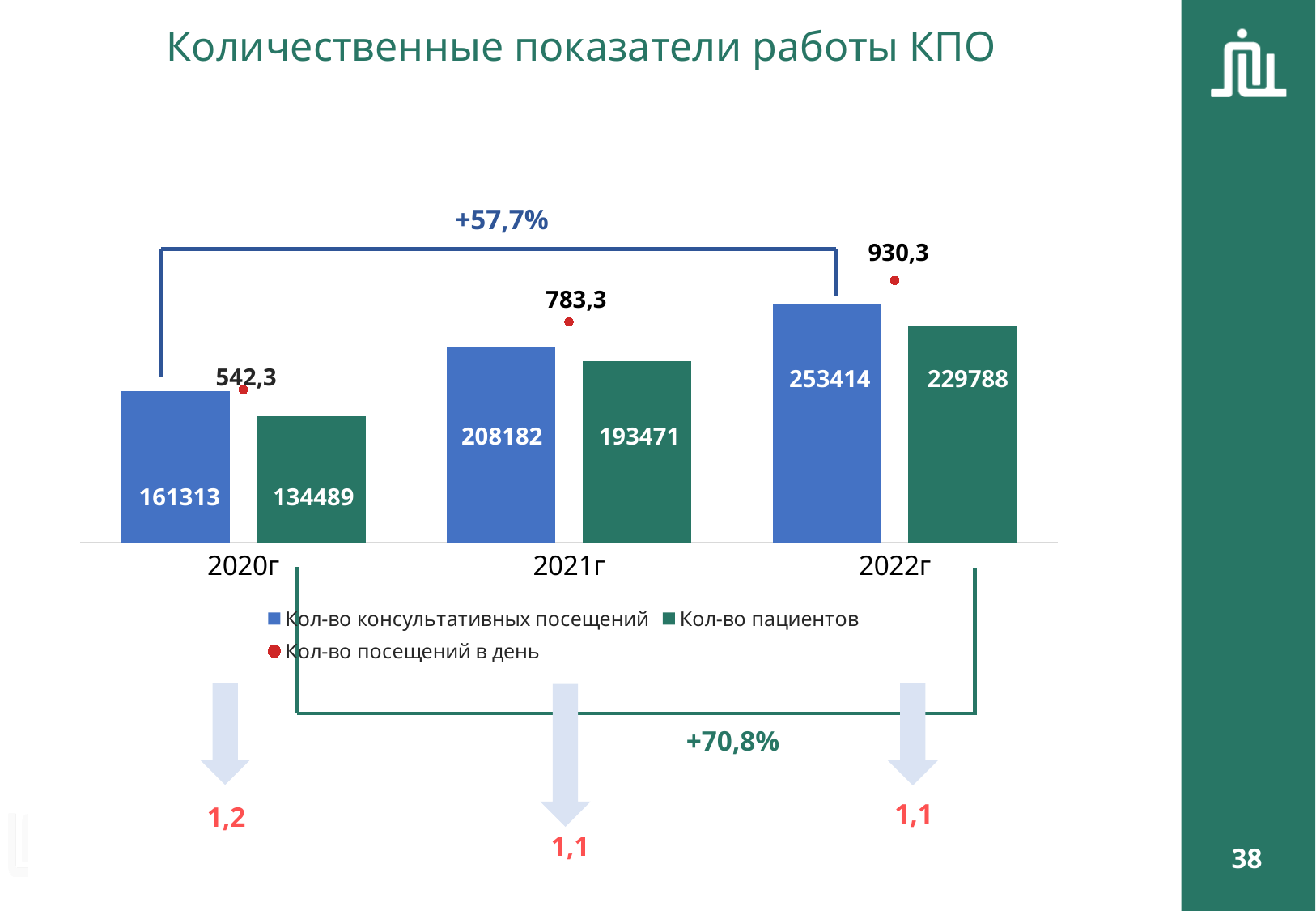
What is the difference between "Кол-во консультативных посещений" and "Кол-во пациентов" in 2021г? 14711 What is the title of the chart? Количественные показатели работы КПО What is the value of "Кол-во консультативных посещений" for 2020г? 161313 Does "Кол-во посещений в день" rise or fall from 2020г to 2022г? Rise Which year has the lowest value for "Кол-во пациентов"? 2020г What is the value of "Кол-во пациентов" for 2022г? 229788 What is the value of "Кол-во посещений в день" for 2021г? 783,3 What kind of chart is used for "Кол-во консультативных посещений" and "Кол-во пациентов"? Bar chart Which year has the highest value for "Кол-во консультативных посещений"? 2022г How many series does the chart legend list? 3 Which is larger in 2022г: "Кол-во консультативных посещений" or "Кол-во пациентов"? Кол-во консультативных посещений How many years are shown on the x axis of the chart? 3